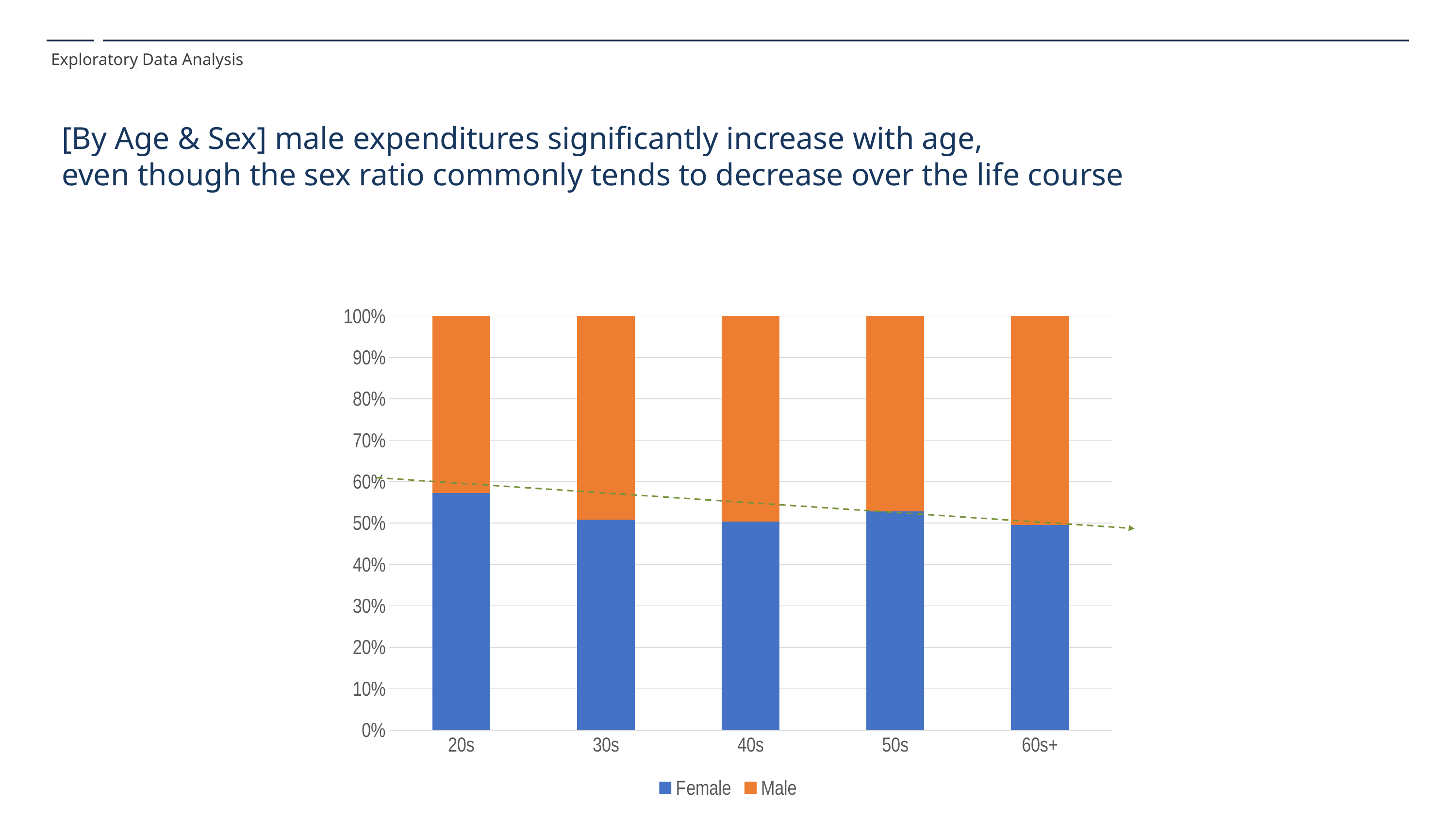
Is the Female value for 20s greater or less than 50%? greater What kind of chart is shown on the slide? Stacked bar chart Which colour represents the Male series? Orange Which age group has the highest Female share? 20s Is the Male value for 20s greater or less than 50%? less Which is larger, the Female share for 20s or the Female share for 50s? 20s Is the Female value for 20s greater or less than 60%? less Which two series are listed in the legend? Female and Male What is the total height of the stacked bar for 20s? 100% How many series does the legend list? 2 How many age categories are shown on the x axis? 5